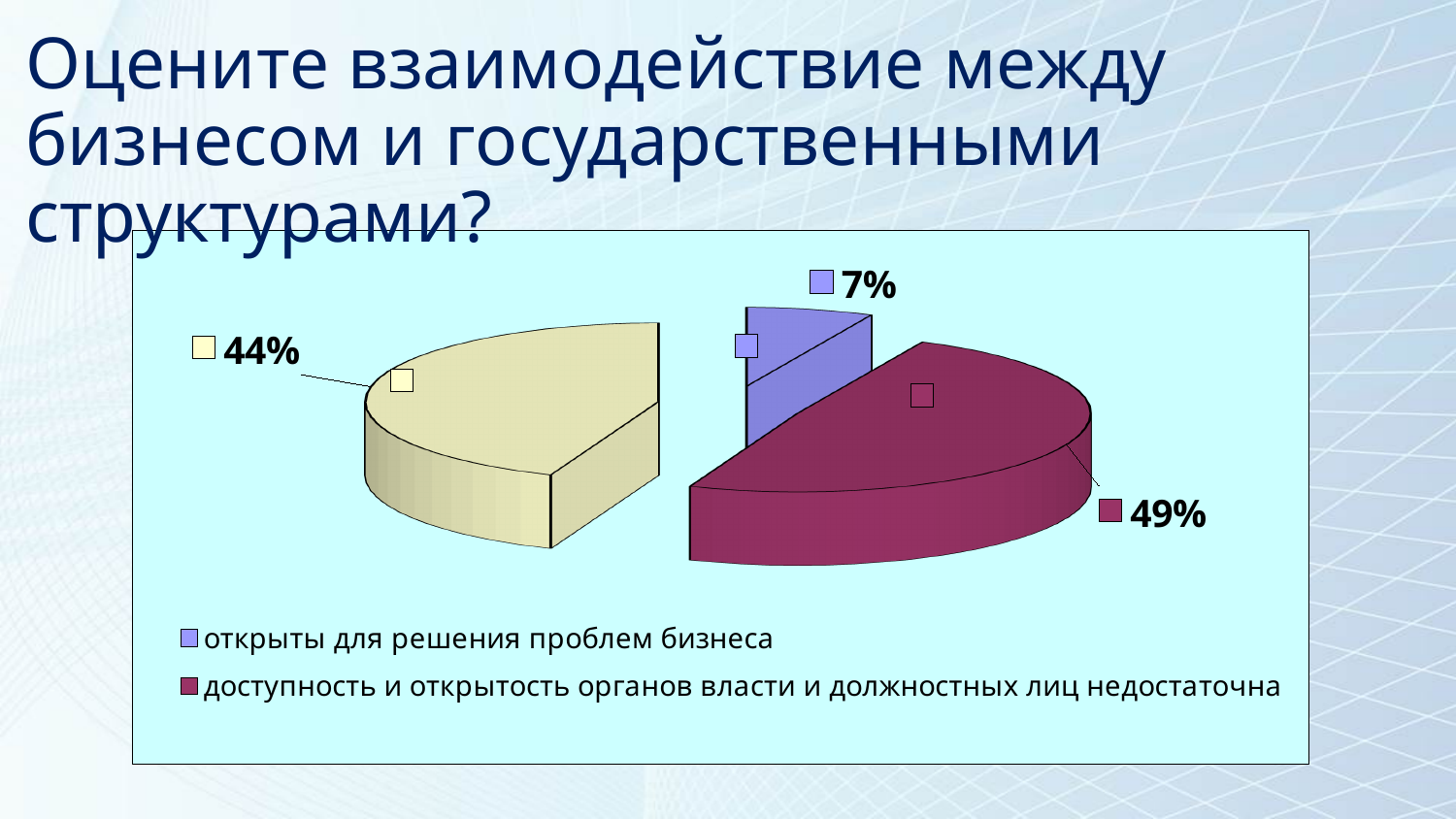
What colour is the slice labelled 49%? maroon (dark red) What kind of chart is shown on the slide? pie chart What percentage of respondents answered "доступность и открытость органов власти и должностных лиц недостаточна"? 49% What percentage of respondents answered "открыты для решения проблем бизнеса"? 7% What is the difference in percentage points between the 49% slice and the 44% slice? 5 What percentage is shown for the beige (light yellow) slice of the pie? 44% What is the difference in percentage points between the 49% slice and the 7% slice? 42 How many slices does the pie chart have? 3 Which is larger: the share for "открыты для решения проблем бизнеса" or the share for "доступность и открытость органов власти и должностных лиц недостаточна"? доступность и открытость органов власти и должностных лиц недостаточна Which slice of the pie is the largest? доступность и открытость органов власти и должностных лиц недостаточна (49%) How many entries are listed in the chart legend? 2 Which slice of the pie is the smallest? открыты для решения проблем бизнеса (7%)